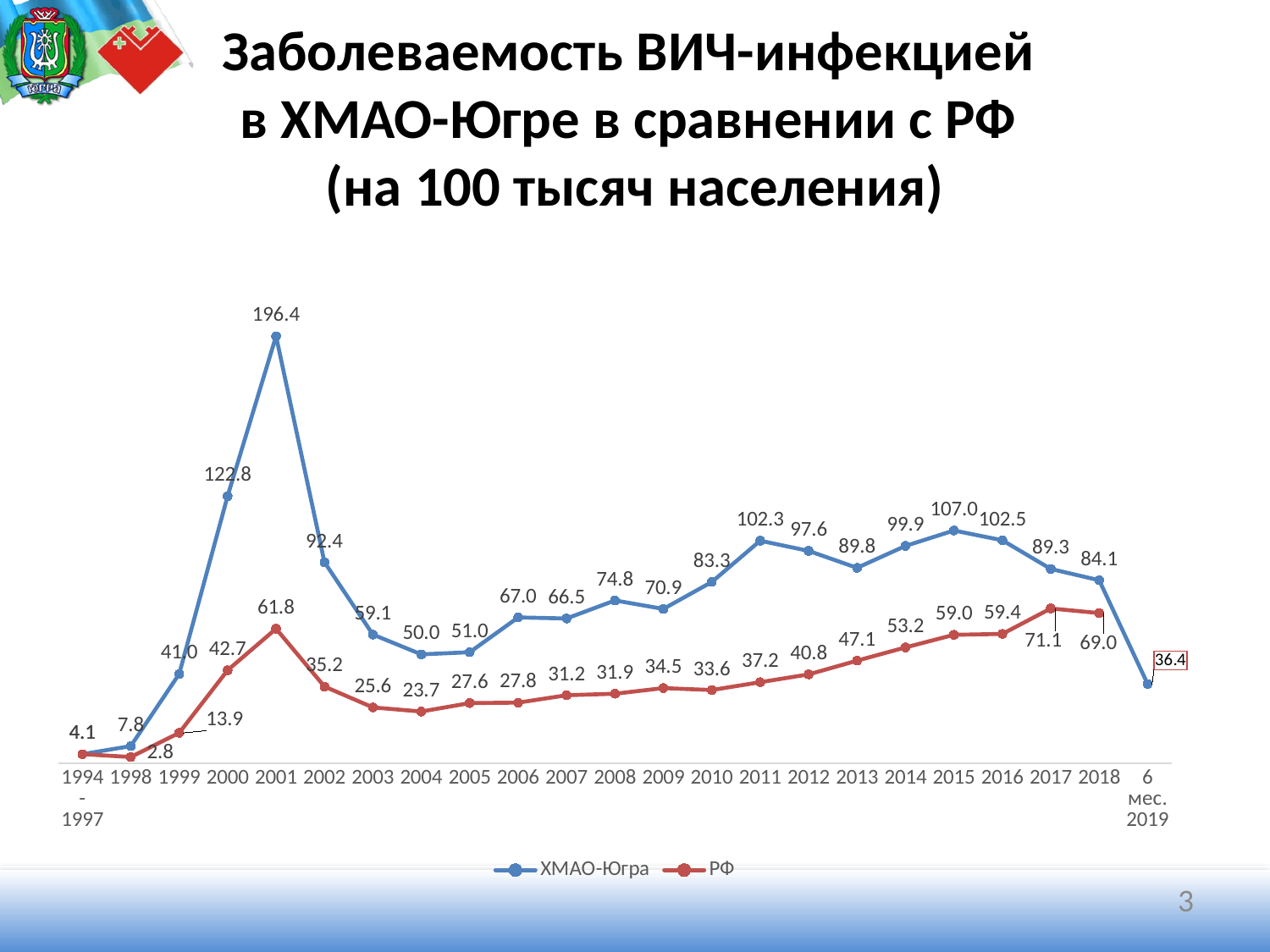
What is the value for ХМАО-Югра for 6 мес. 2019? 36.4 How many series does the legend list? 2 What kind of chart is shown on the slide? line chart Which series has the larger value in 2015, ХМАО-Югра or РФ? ХМАО-Югра How many categories are shown on the x axis? 23 Does the ХМАО-Югра series rise or fall from 2015 to 2018? fall In which year does the ХМАО-Югра series reach its highest value? 2001 In which year does the РФ series reach its highest value? 2017 What is the value for ХМАО-Югра in 2001? 196.4 By how much did the ХМАО-Югра value increase from 2000 to 2001? 73.6 What is the difference between the ХМАО-Югра and РФ values in 2018? 15.1 What is the value for РФ in 2017? 71.1